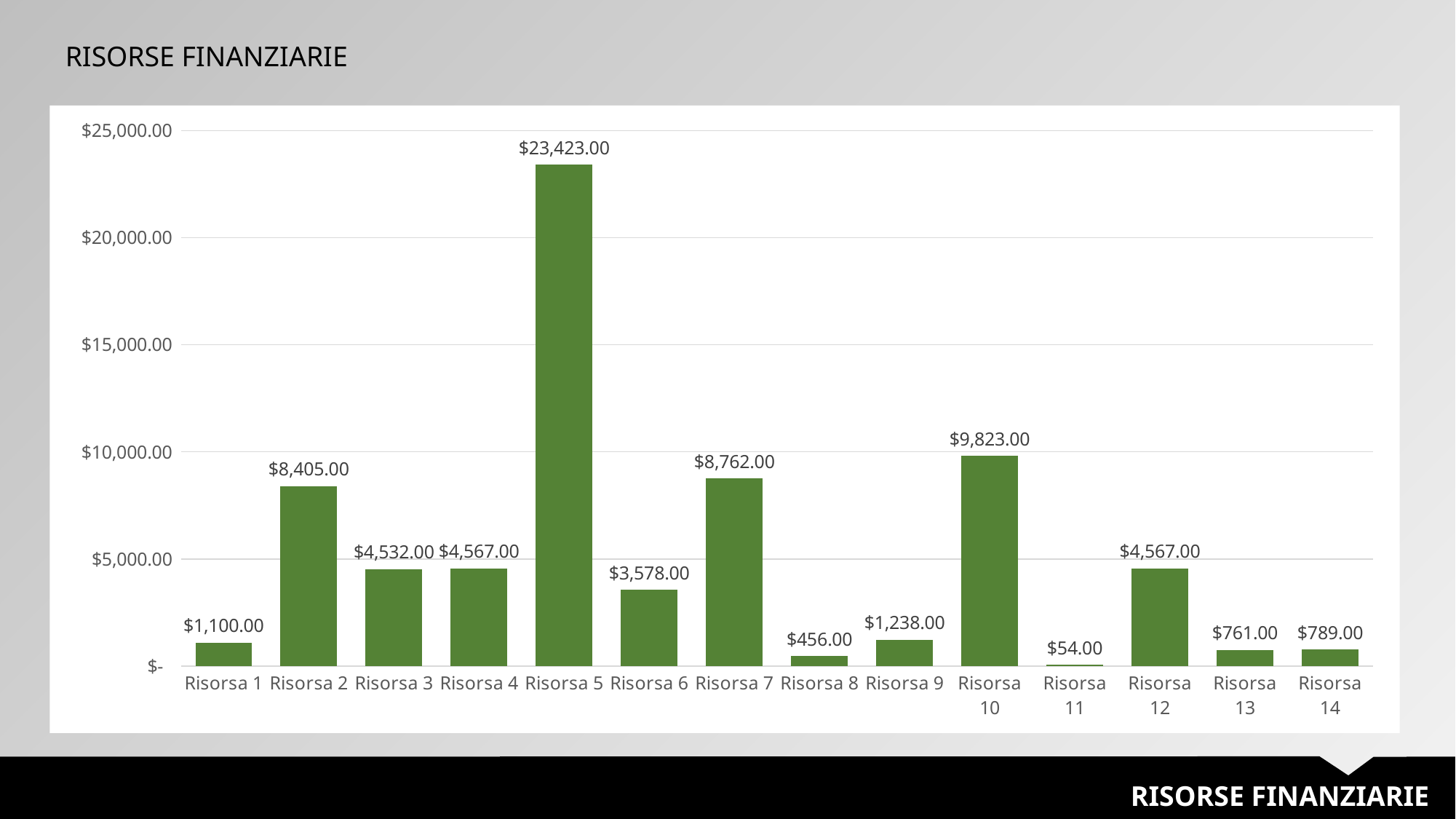
Which category has the highest value? Risorsa 5 Which category has the lowest value? Risorsa 11 What is the difference between the values for Risorsa 2 and Risorsa 7? $357.00 What is the value for Risorsa 11? $54.00 Is the value for Risorsa 10 greater or less than $5,000.00? greater Which is larger, the value for Risorsa 13 or Risorsa 14? Risorsa 14 How many categories are shown on the x axis? 14 What is the difference between the values for Risorsa 4 and Risorsa 3? $35.00 What kind of chart is shown on the slide? bar chart What is the value for Risorsa 5? $23,423.00 What is the title of the slide? RISORSE FINANZIARIE What is the value for Risorsa 10? $9,823.00